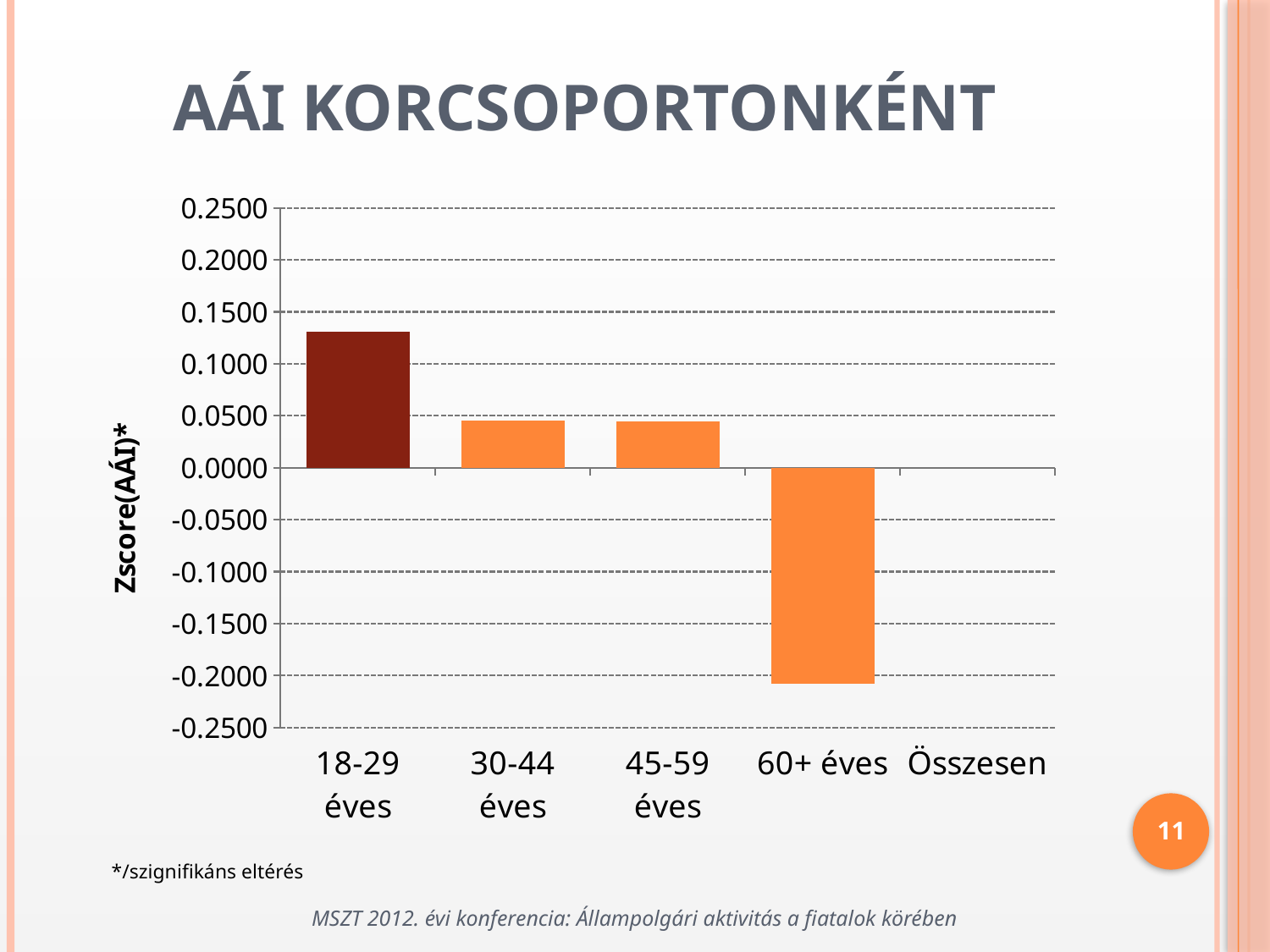
Which category has the lowest Zscore(AÁI) value? 60+ éves Is the value for 18-29 éves greater or less than 0.1000? greater What is the title of the slide containing the chart? AÁI KORCSOPORTONKÉNT Is the value for 60+ éves greater or less than -0.1500? less Which is larger, the value for 45-59 éves or the value for 60+ éves? 45-59 éves Which category has the highest Zscore(AÁI) value? 18-29 éves Do the values generally rise or fall moving from the 18-29 éves group to the 60+ éves group? fall How many age-group categories are shown on the x axis? 5 What kind of chart is shown on the slide? bar chart What is the label of the vertical axis? Zscore(AÁI)* Which is larger, the value for 18-29 éves or the value for 30-44 éves? 18-29 éves